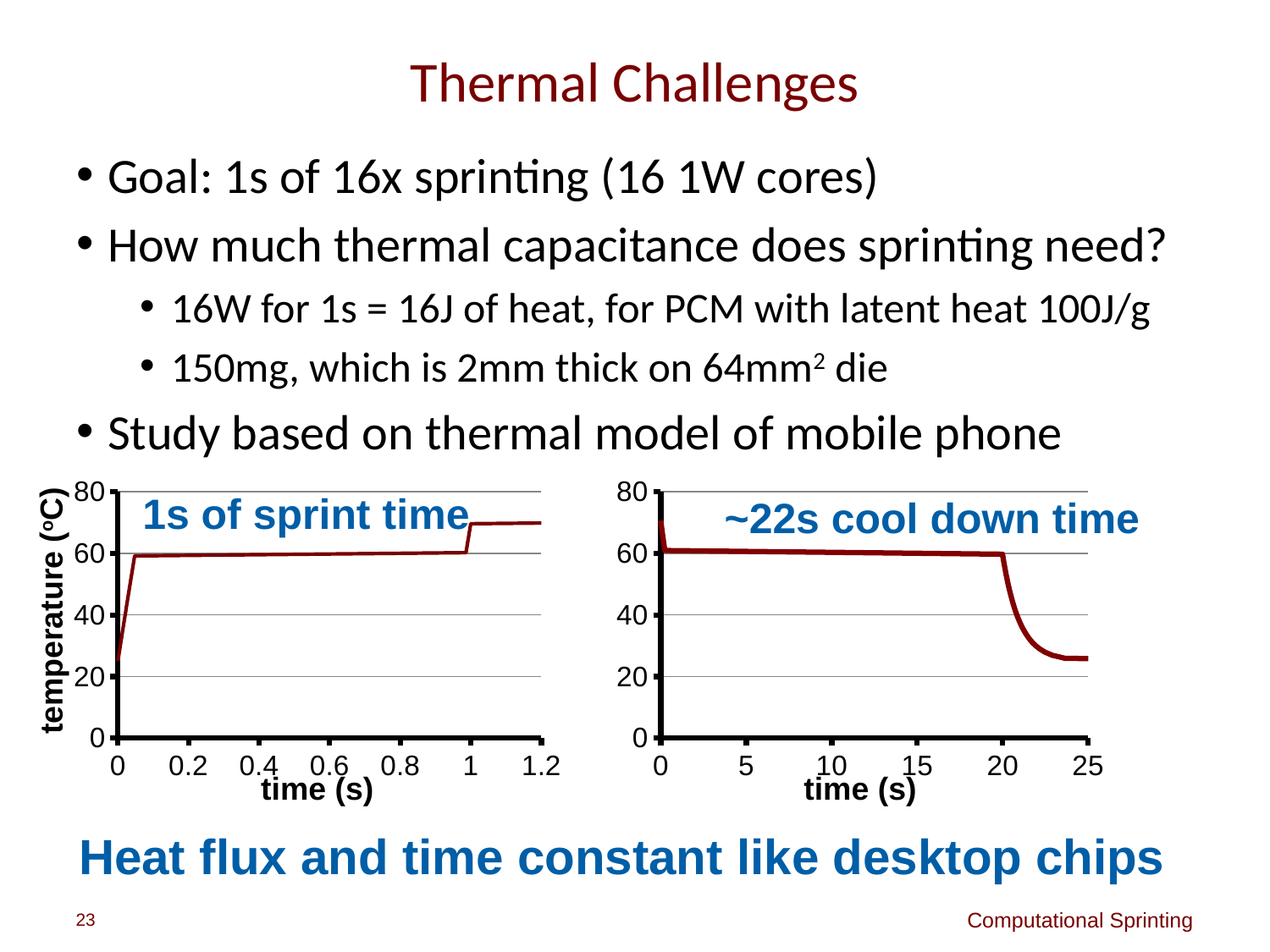
What annotation text is written inside the right chart? ~22s cool down time In the left chart, is the temperature at time 0 greater or less than 40? less In the right chart, is the temperature at time 24 s greater or less than 40? less In the left chart, does the temperature overall rise or fall as time increases from 0 to 1.2 s? rise In the right chart, does the temperature overall rise or fall as time increases from 0 to 25 s? fall In the right chart, is the temperature at time 0 greater or less than 60? greater What kind of chart is the right chart on the slide? line chart What kind of chart is the left chart on the slide? line chart What is the label on the y axis of the left chart? temperature (°C)